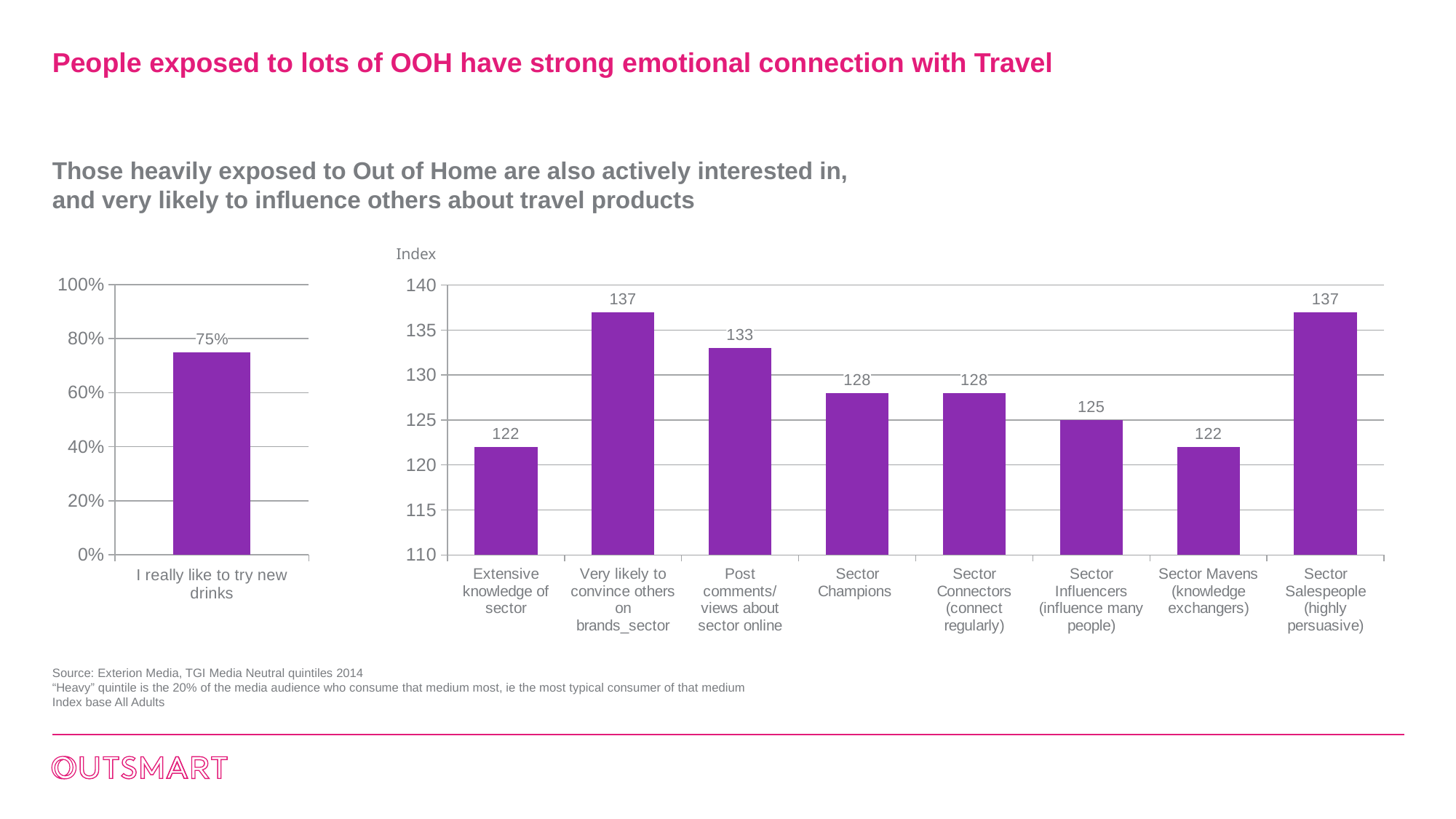
What kind of chart is the right chart (Index)? bar chart In the right chart (Index), is the value for 'Sector Connectors (connect regularly)' greater or less than 125? greater In the right chart (Index), what is the difference between 'Very likely to convince others on brands_sector' and 'Extensive knowledge of sector'? 15 In the left chart, is the value for 'I really like to try new drinks' greater or less than 60%? greater How many categories are shown in the right chart (Index)? 8 In the right chart (Index), what is the value for 'Sector Champions'? 128 In the right chart (Index), what is the value for 'Sector Influencers (influence many people)'? 125 In the right chart (Index), which is larger: 'Post comments/ views about sector online' or 'Sector Mavens (knowledge exchangers)'? Post comments/ views about sector online What is the title of the slide? People exposed to lots of OOH have strong emotional connection with Travel In the right chart (Index), what is the value for 'Sector Salespeople (highly persuasive)'? 137 In the right chart (Index), what is the value for 'Post comments/ views about sector online'? 133 In the left chart, what is the value for 'I really like to try new drinks'? 75%